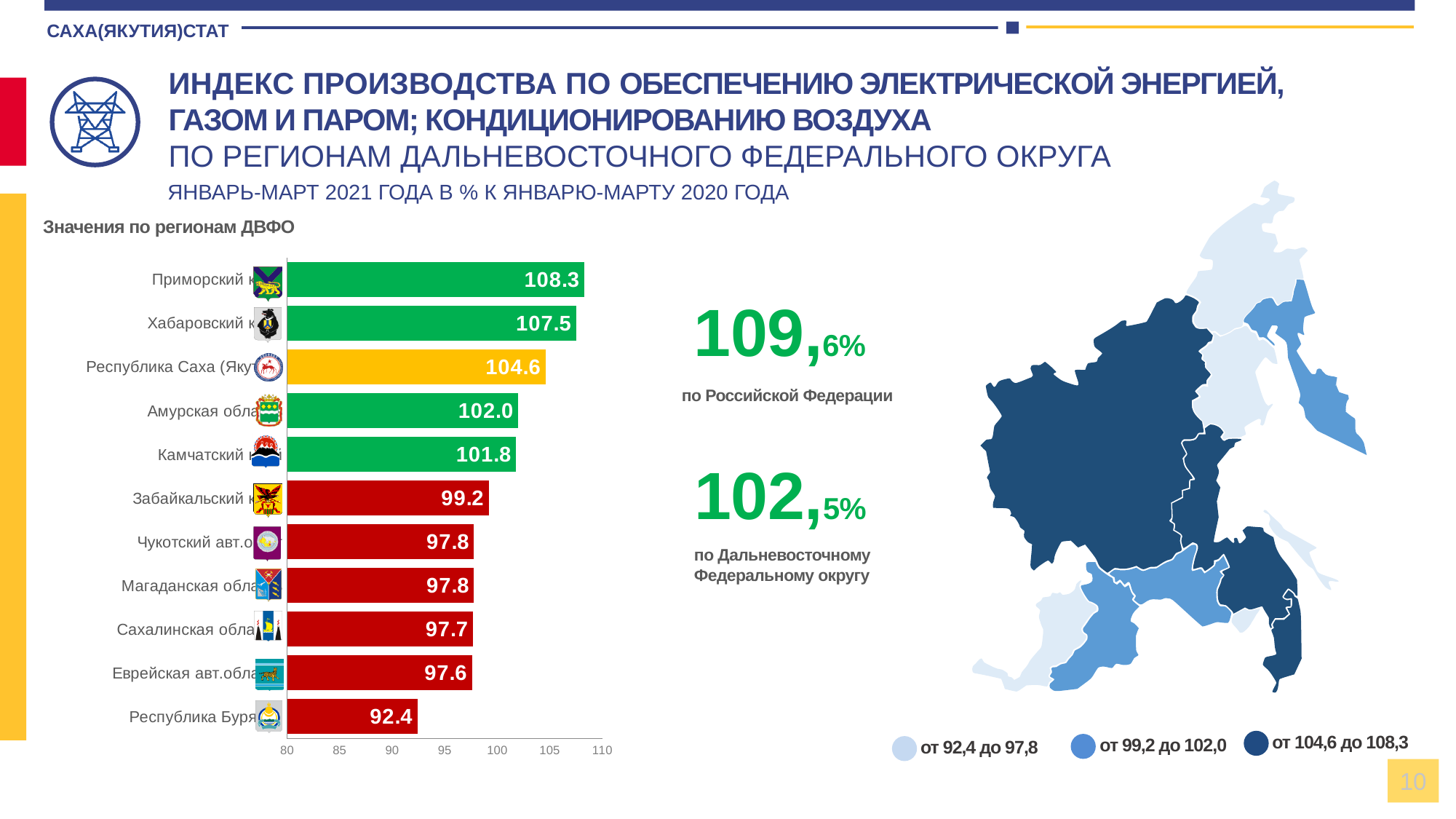
What is the difference between the values for Республика Саха (Якутия) and Республика Бурятия? 12.2 What is the difference between the values for Приморский край and Хабаровский край? 0.8 Which region has the lowest value in the bar chart? Республика Бурятия What is the value for Республика Бурятия in the bar chart? 92.4 What is the value for Приморский край in the bar chart? 108.3 How many regions are shown in the bar chart? 11 What kind of chart is used to show the values by region? bar chart Is the value for Камчатский край greater or less than 100? greater Which region has the highest value in the bar chart? Приморский край Which is larger: the value for Амурская область or the value for Забайкальский край? Амурская область What colour is the bar for Республика Саха (Якутия)? yellow What is the value for Республика Саха (Якутия) in the bar chart? 104.6